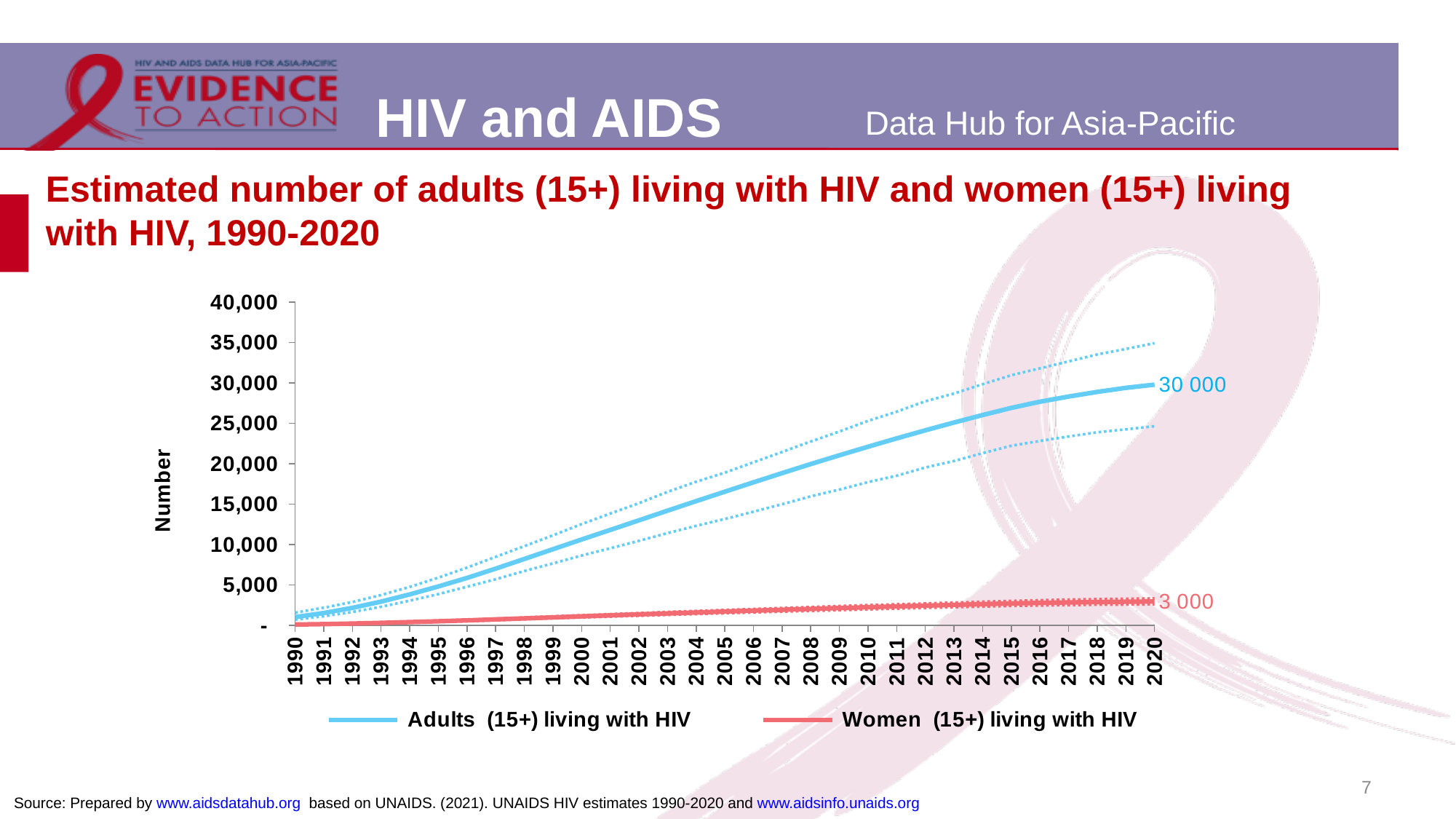
Is the value for women (15+) living with HIV in 2015 greater or less than 5,000? less What is the label of the vertical axis? Number Does the number of adults (15+) living with HIV rise or fall from 1990 to 2020? Rise Is the value for adults (15+) living with HIV in 2010 greater or less than 15,000? greater What is the estimated number of adults (15+) living with HIV in 2020? 30 000 How many series does the legend list? 2 What is the estimated number of women (15+) living with HIV in 2020? 3 000 What is the difference between the 2020 values for adults (15+) living with HIV and women (15+) living with HIV? 27 000 What colour is the line for women (15+) living with HIV? Red Is the value for adults (15+) living with HIV in 2000 greater or less than 15,000? less In 2020, which series has the larger value: adults (15+) living with HIV or women (15+) living with HIV? Adults (15+) living with HIV What kind of chart is shown on the slide? Line chart